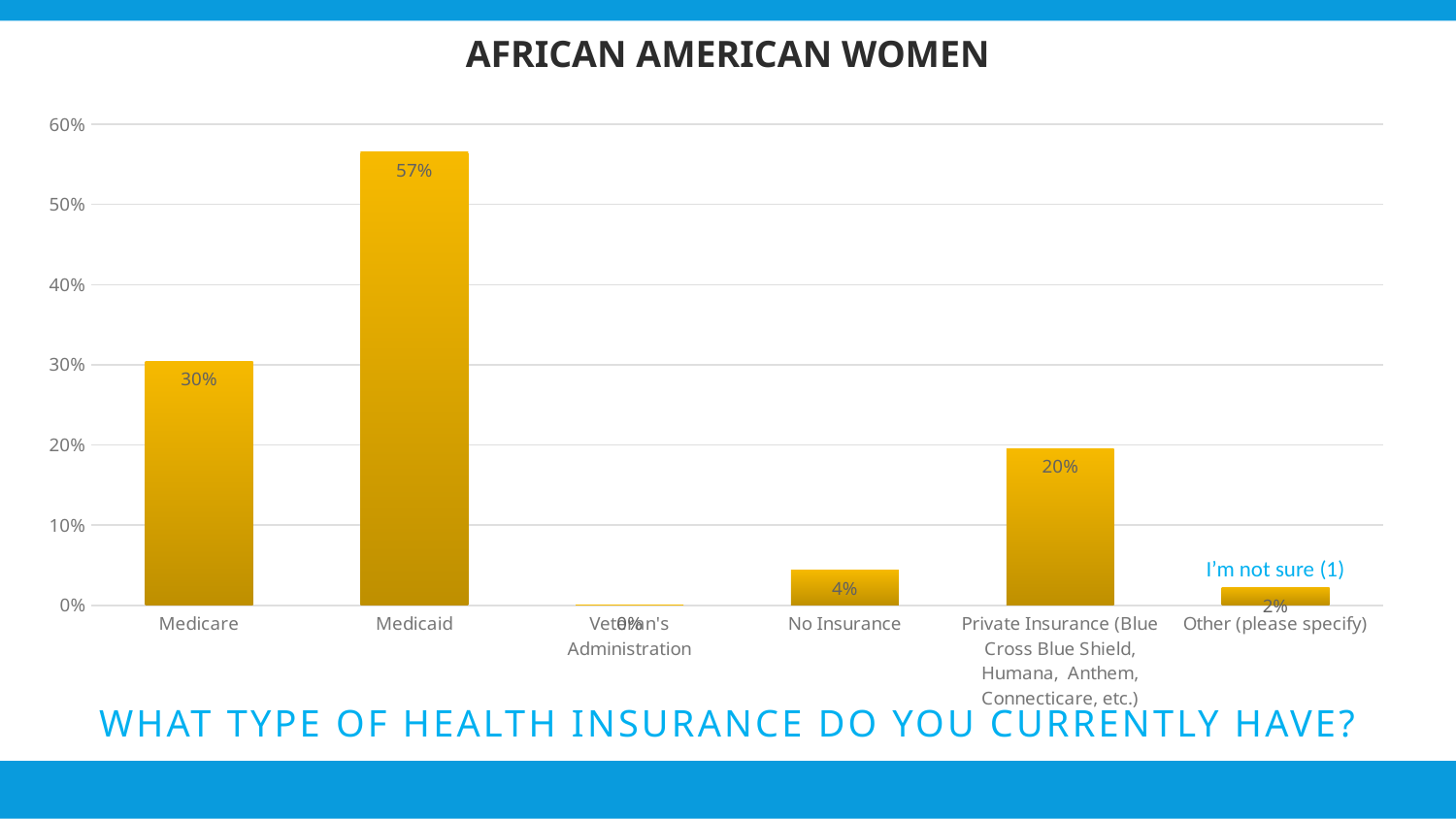
Which category has the lowest value? Veteran's Administration What kind of chart is shown on the slide? Bar chart What is the value shown for Other (please specify)? 2% How many insurance categories are shown on the x axis? 6 Which insurance type has the highest percentage? Medicaid What is the title of the chart? AFRICAN AMERICAN WOMEN What percentage is shown for No Insurance? 4% What is the value for Private Insurance? 20% What percentage of African American women have Medicaid? 57% What is the difference between the Medicaid and Medicare percentages? 27% Which is larger, the value for Private Insurance or the value for No Insurance? Private Insurance What is the value shown for Medicare? 30%